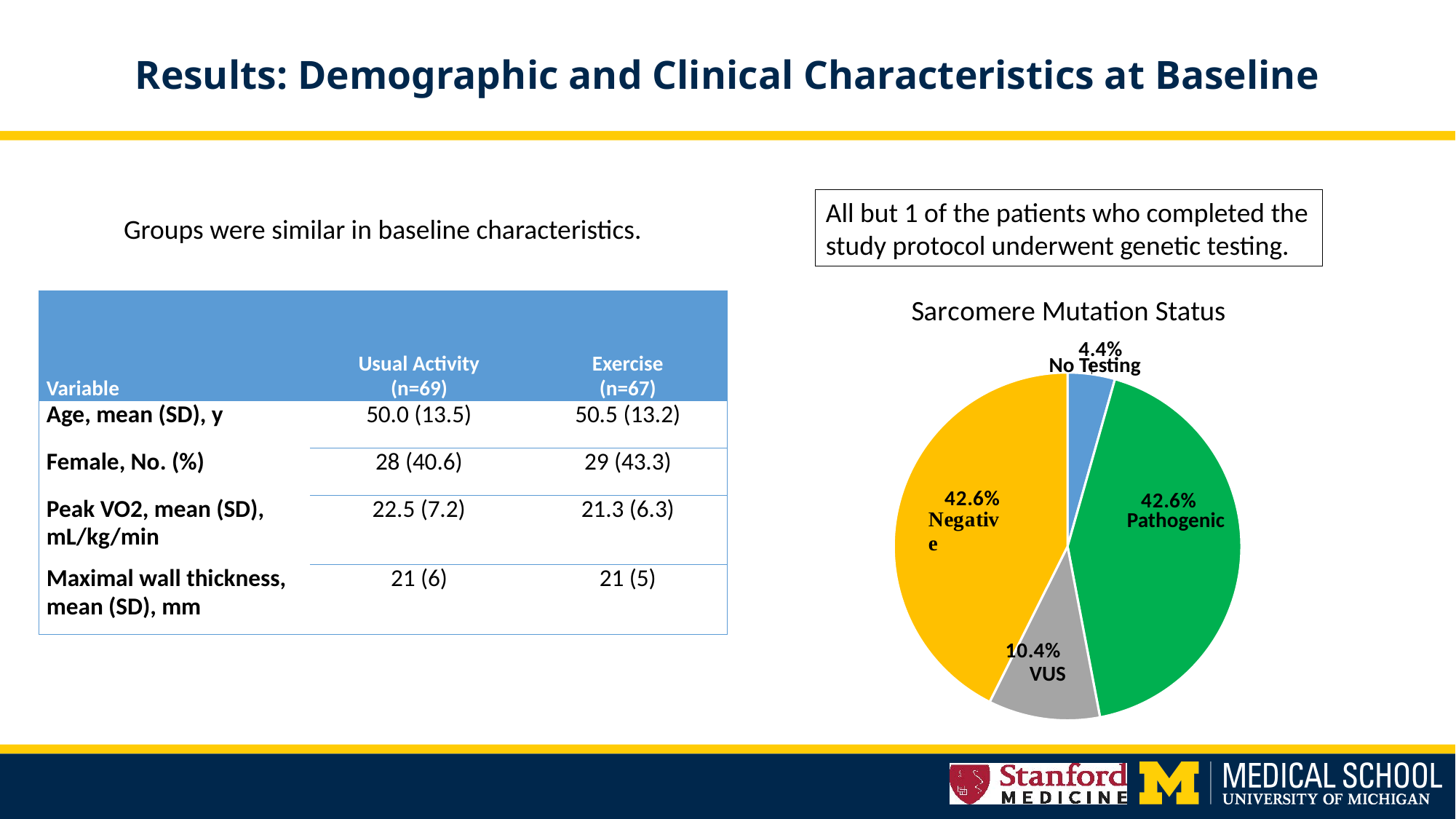
In the Sarcomere Mutation Status pie chart, what is the difference between the VUS share and the No Testing share? 6.0% Which slice of the Sarcomere Mutation Status pie chart is the smallest? No Testing In the Sarcomere Mutation Status pie chart, what percentage is labelled VUS? 10.4% In the Sarcomere Mutation Status pie chart, what share is labelled Negative? 42.6% What is the title of the pie chart on the slide? Sarcomere Mutation Status How many slices does the Sarcomere Mutation Status pie chart have? 4 In the Sarcomere Mutation Status pie chart, what colour is the Pathogenic slice? green In the Sarcomere Mutation Status pie chart, which is larger: VUS or No Testing? VUS What kind of chart is shown under the title "Sarcomere Mutation Status"? pie chart In the Sarcomere Mutation Status pie chart, what share of patients had a Pathogenic mutation? 42.6% In the Sarcomere Mutation Status pie chart, what percentage of patients had No Testing? 4.4% In the Sarcomere Mutation Status pie chart, what is the difference between the Pathogenic share and the VUS share? 32.2%